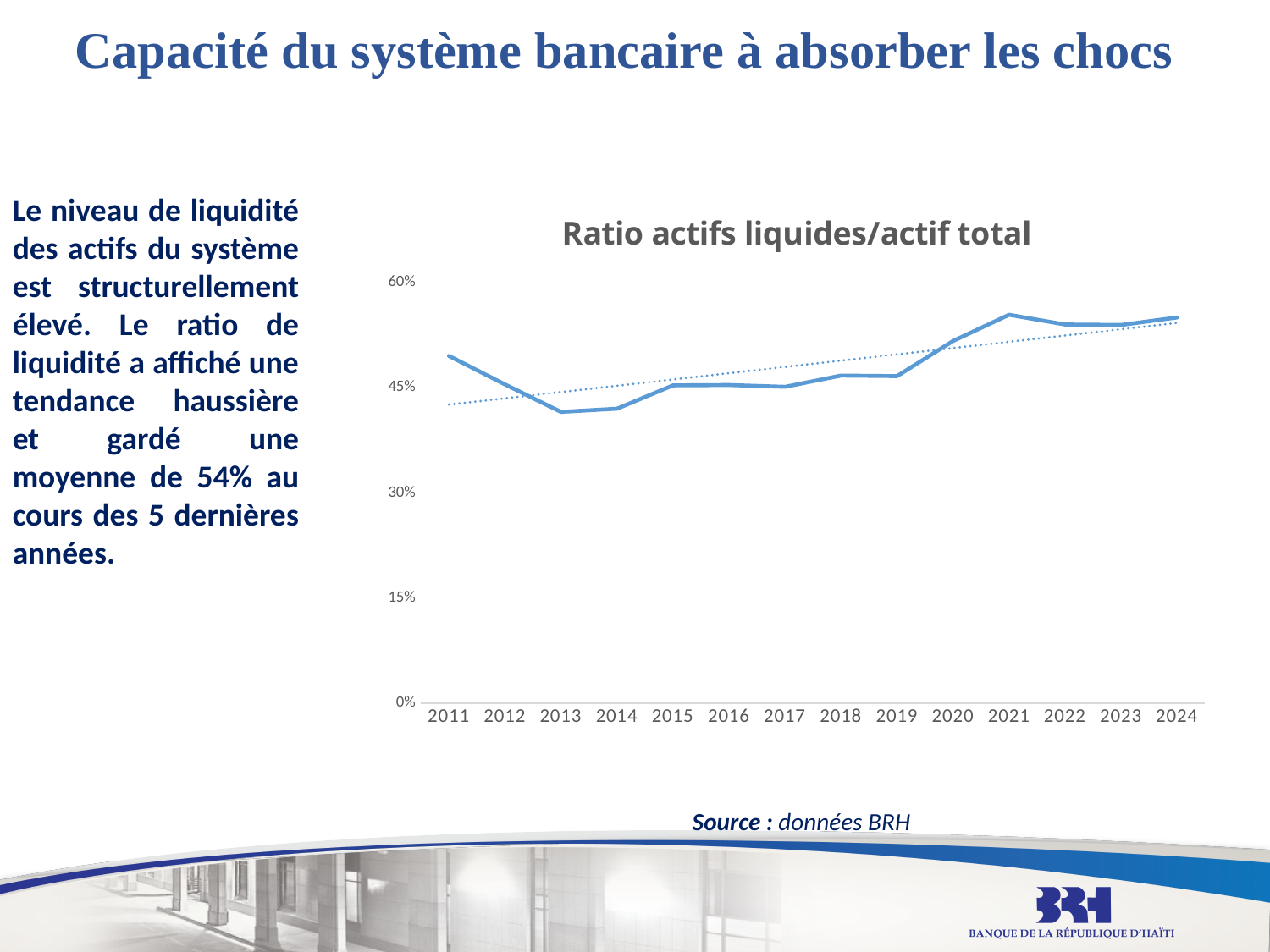
How many years are plotted along the x axis of the chart? 14 Which is larger, the value for 2021 or the value for 2013? 2021 What is the title of the chart? Ratio actifs liquides/actif total What kind of chart is shown on the slide? line chart Is the value for 2024 greater or less than 60%? less Is the value for 2013 greater or less than 45%? less Which is larger, the value for 2011 or the value for 2014? 2011 Is the value for 2021 greater or less than 45%? greater Overall, do the values rise or fall from 2011 to 2024? rise Which year has the lowest value in the chart? 2013